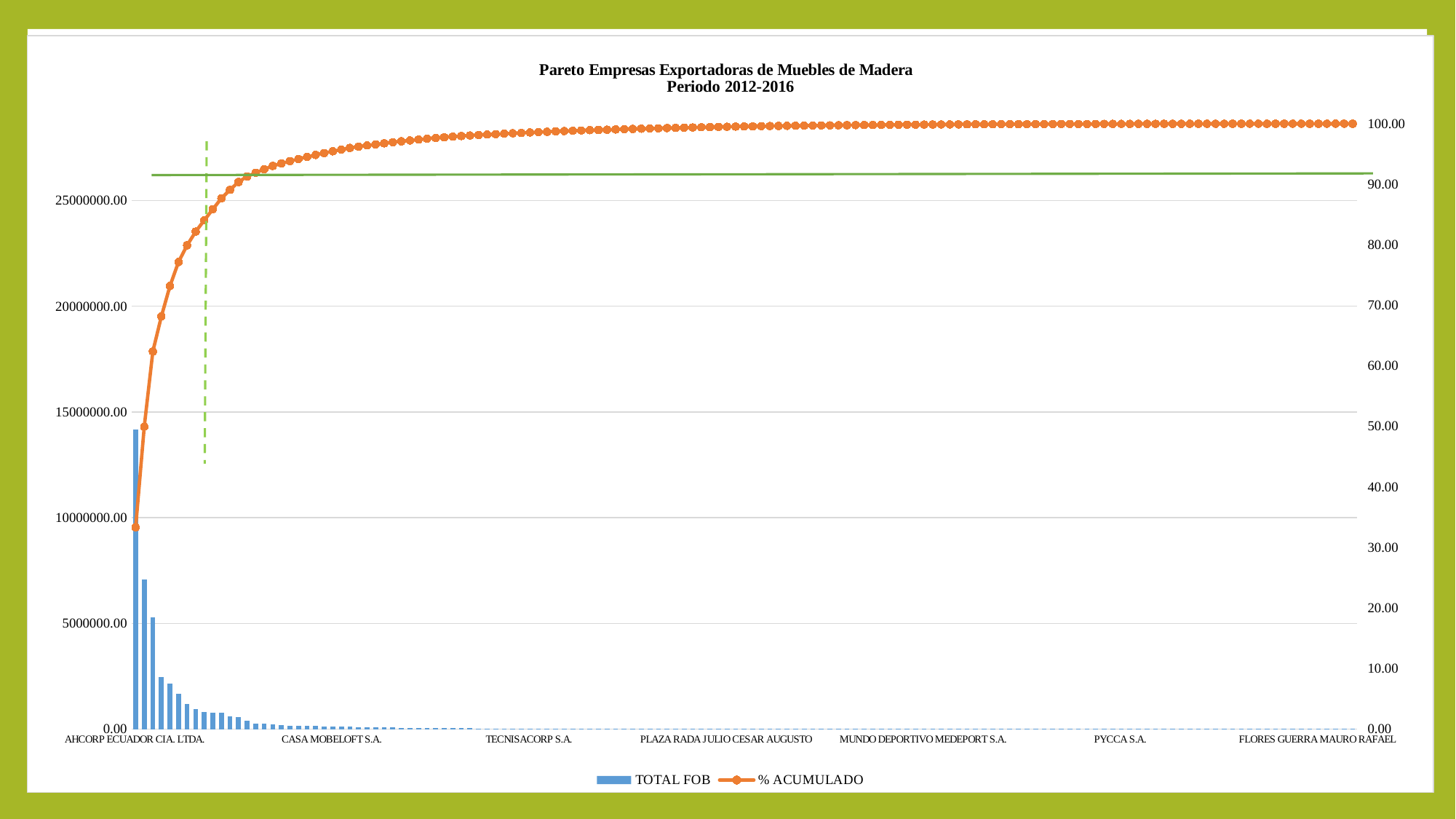
What kind of chart is this? A combined bar and line chart (Pareto chart) What are the names of the two series in the legend? TOTAL FOB and % ACUMULADO What is the title of the chart? Pareto Empresas Exportadoras de Muebles de Madera Periodo 2012-2016 Is the TOTAL FOB value for AHCORP ECUADOR CIA. LTDA. greater or less than 10000000.00? greater Do the TOTAL FOB bars rise or fall from left to right along the x axis? fall Which is larger, the TOTAL FOB for AHCORP ECUADOR CIA. LTDA. or for PYCCA S.A.? AHCORP ECUADOR CIA. LTDA. Is the % ACUMULADO value for FLORES GUERRA MAURO RAFAEL greater or less than 90.00? greater Does the % ACUMULADO line rise or fall from left to right along the x axis? rise Is the TOTAL FOB value for AHCORP ECUADOR CIA. LTDA. greater or less than 15000000.00? less How many series does the legend list? 2 Which company has the highest TOTAL FOB bar? AHCORP ECUADOR CIA. LTDA.